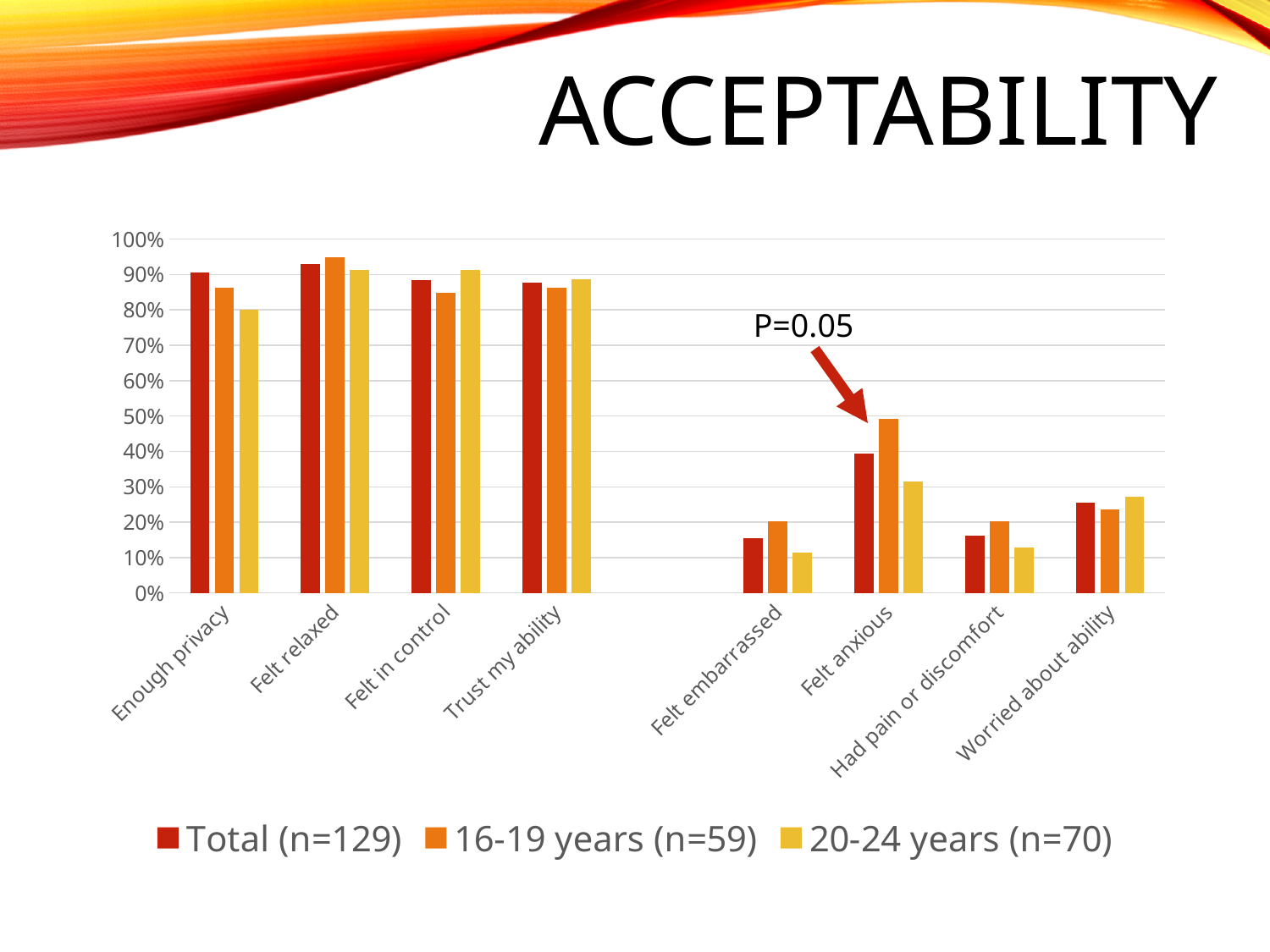
In the Felt in control category, which is larger: the value for 16-19 years (n=59) or for 20-24 years (n=70)? 20-24 years (n=70) Is the value for 20-24 years (n=70) in the Felt embarrassed category greater or less than 20%? less What kind of chart is shown on the slide? bar chart In the Enough privacy category, which series has the lowest value? 20-24 years (n=70) Is the value for 20-24 years (n=70) in the Enough privacy category greater or less than 90%? less Is the value for Total (n=129) in the Worried about ability category greater or less than 30%? less Which category does the P=0.05 annotation arrow point to? Felt anxious In the Felt anxious category, which is larger: the value for 16-19 years (n=59) or for 20-24 years (n=70)? 16-19 years (n=59) How many categories are shown on the x axis? 8 How many series does the legend list? 3 For the Total (n=129) series, which category has the highest value? Felt relaxed